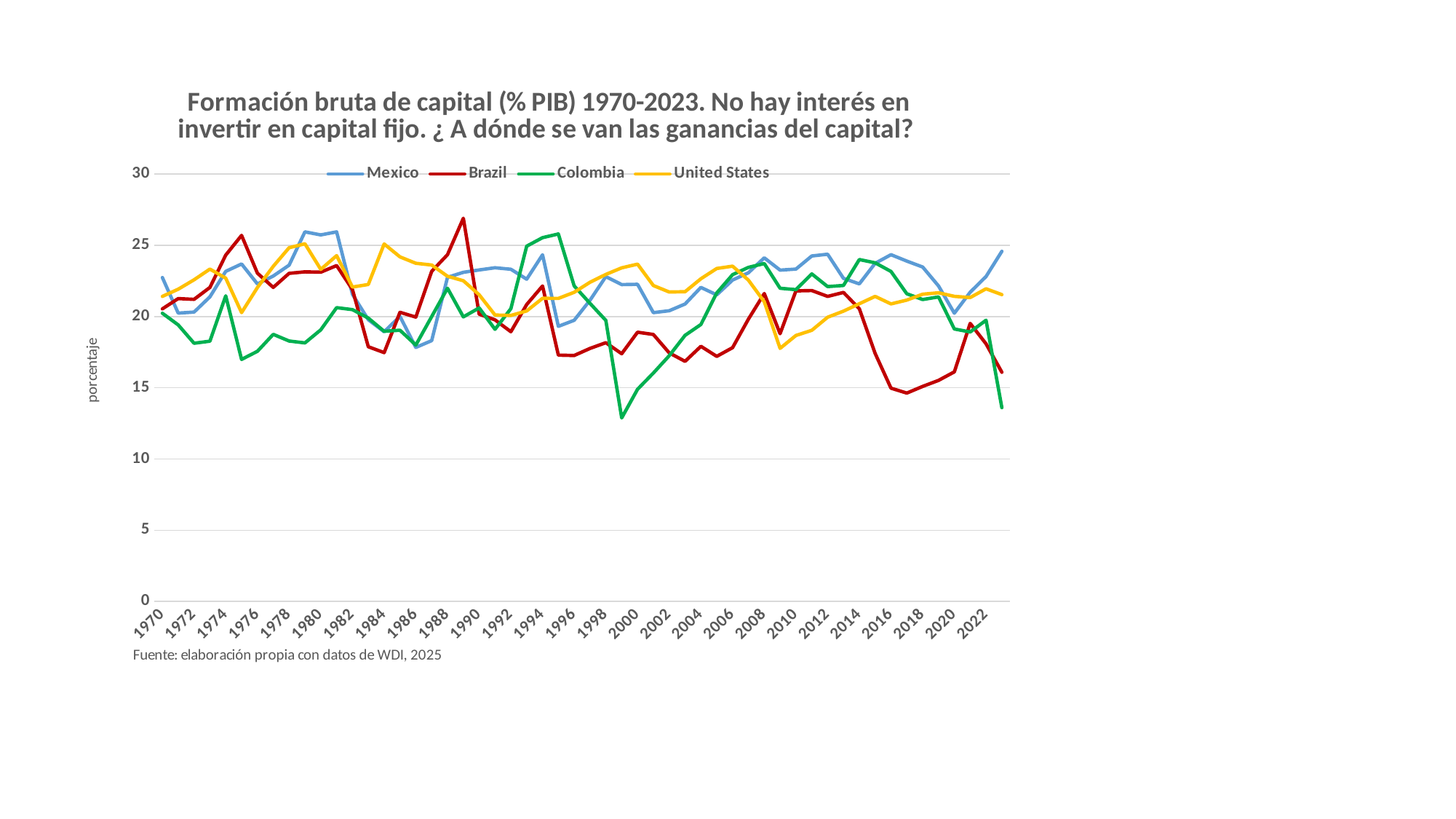
Is the value for Mexico in 1980 greater or less than 25? greater What is the label on the vertical axis of the chart? porcentaje Which series has the lowest value in 2023? Colombia Is the value for United States in 2009 greater or less than 20? less Which countries are listed in the chart legend? Mexico, Brazil, Colombia, United States In 2023, which is higher, Mexico or Colombia? Mexico In 1999, which is higher, Brazil or Colombia? Brazil Is the value for Colombia in 2023 greater or less than 15? less How many series does the legend list? 4 What kind of chart is shown on the slide? Line chart